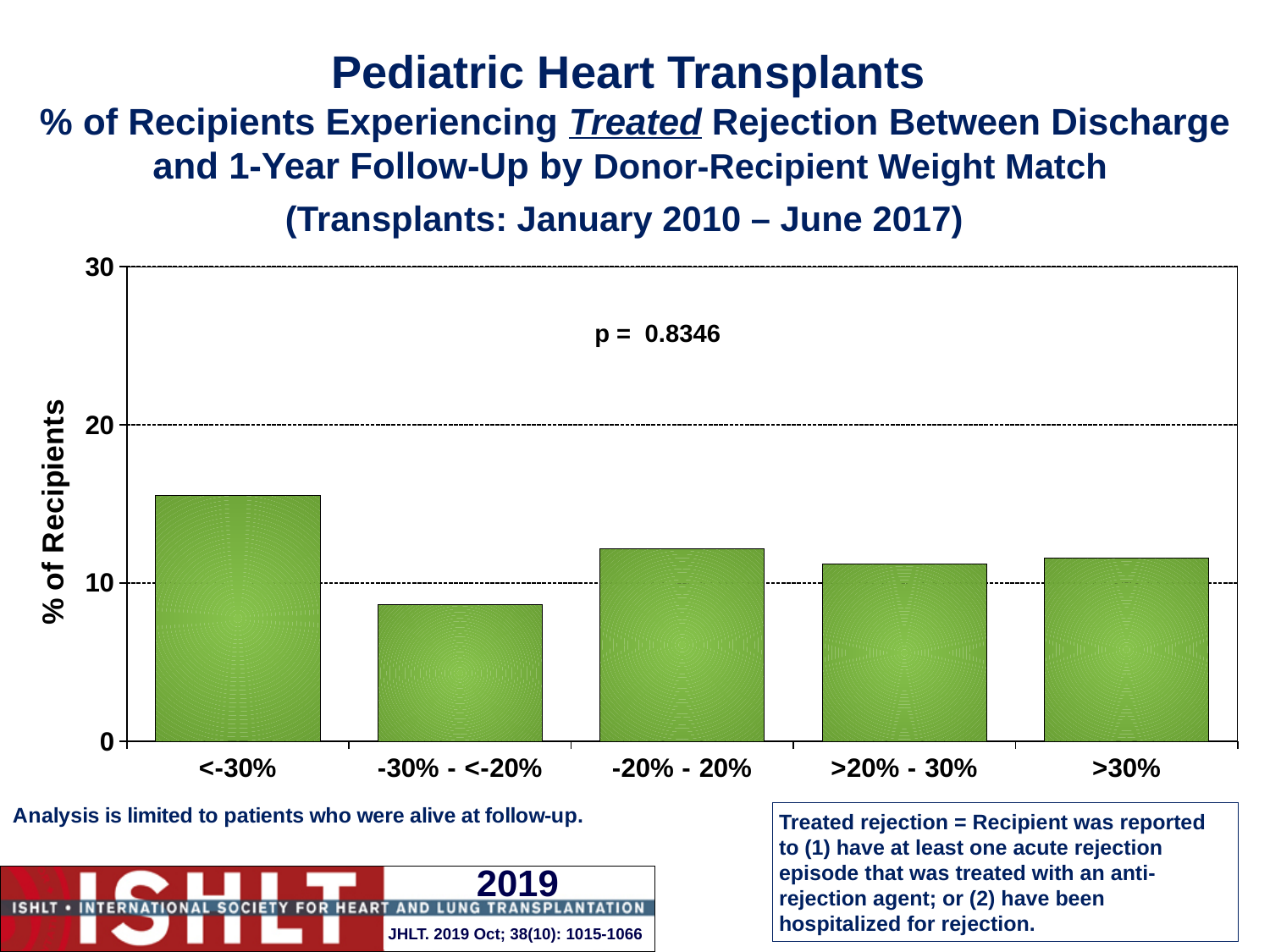
Is the value for the -20% - 20% category greater or less than 10? greater What is the label of the y axis? % of Recipients Is the value for the <-30% category greater or less than 10? greater Which weight match category has the lowest % of recipients experiencing treated rejection? -30% - <-20% Which weight match category has the highest % of recipients experiencing treated rejection? <-30% How many donor-recipient weight match categories are shown on the x axis? 5 Which has a higher % of recipients: the <-30% category or the -30% - <-20% category? <-30% Is the value for the <-30% category greater or less than 20? less What p-value is printed on the chart? p = 0.8346 What kind of chart is shown on the slide? bar chart Which has a higher % of recipients: the -20% - 20% category or the -30% - <-20% category? -20% - 20%